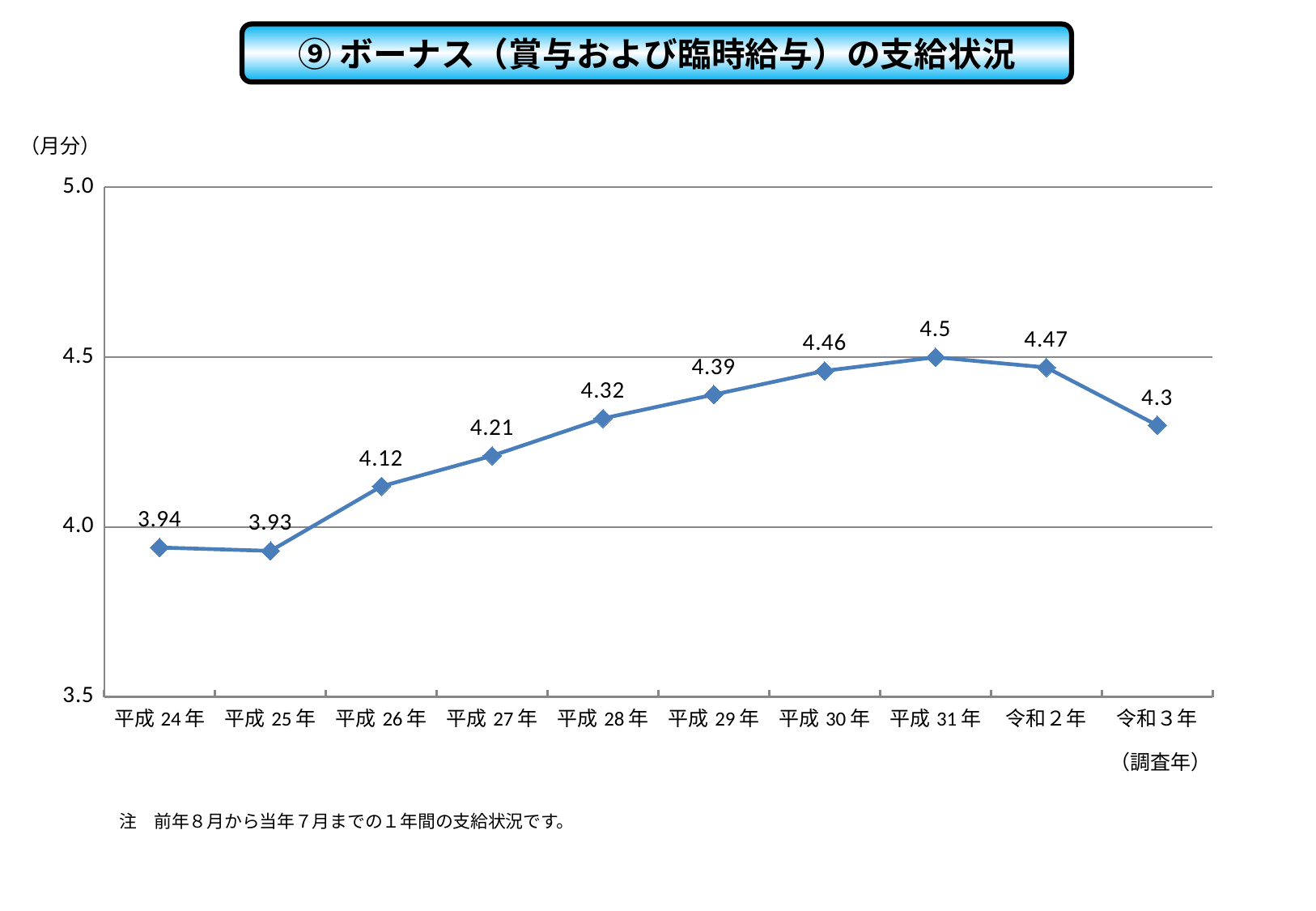
Which year has the highest value? 平成 31 年 What is the difference between the values for 平成 31 年 and 令和 3 年? 0.2 Which is larger, the value for 平成 29 年 or the value for 令和 2 年? 令和 2 年 What is the difference between the values for 平成 26 年 and 平成 24 年? 0.18 What kind of chart is shown on the slide? line chart What is the value for 平成 28 年? 4.32 What is the value for 平成 24 年? 3.94 Do the values rise or fall from 平成 25 年 to 平成 31 年? rise How many years are plotted on the x axis? 10 Which year has the lowest value? 平成 25 年 Is the value for 平成 27 年 greater or less than 4.0? greater What is the value for 令和 3 年? 4.3